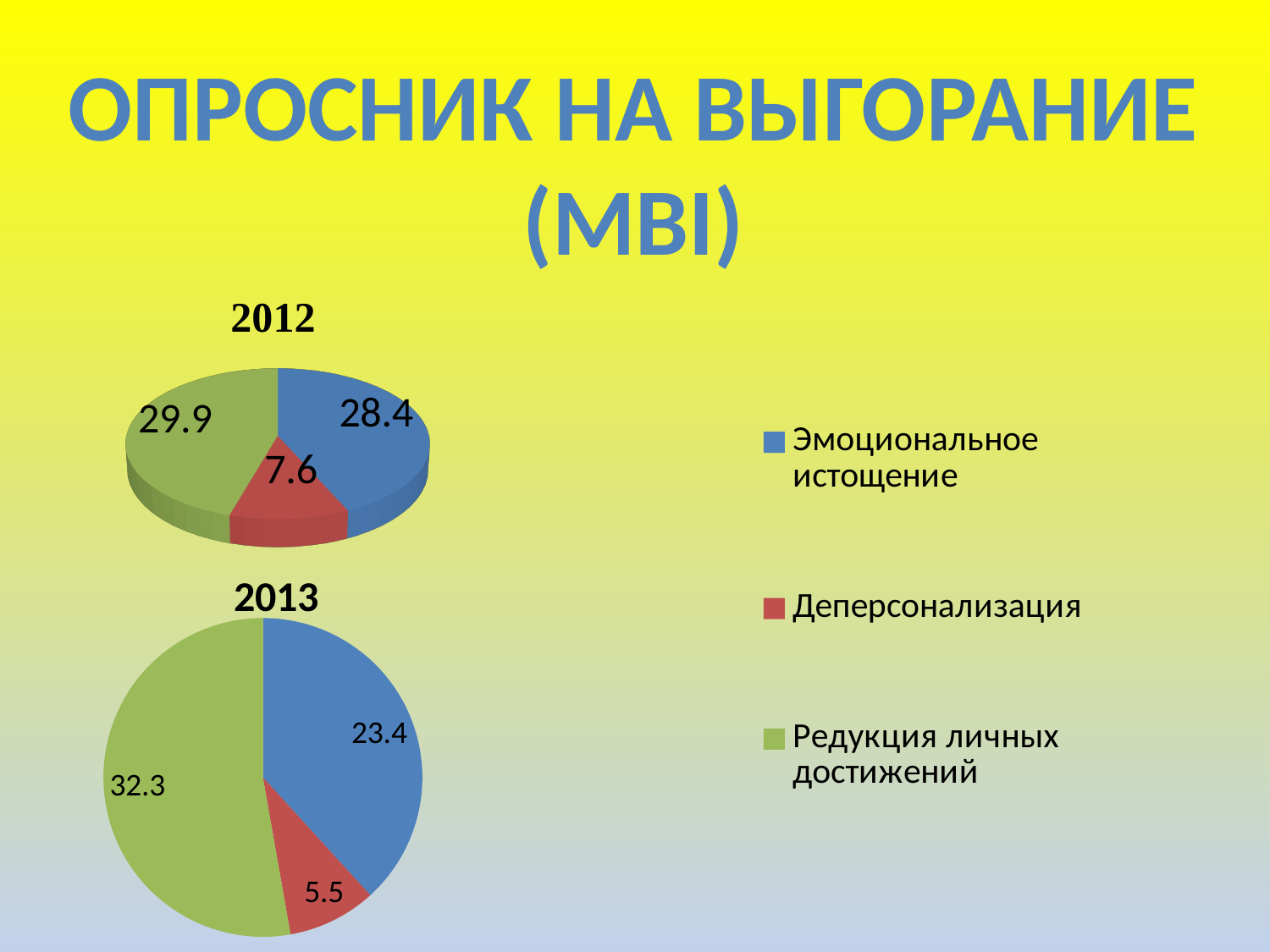
In the 2013 chart, what is the value for Редукция личных достижений? 32.3 How many slices does the 2013 chart have? 3 In the 2013 chart, which category has the largest value? Редукция личных достижений In the 2013 chart, what is the difference between Редукция личных достижений and Эмоциональное истощение? 8.9 In the 2012 chart, what is the difference between Эмоциональное истощение and Деперсонализация? 20.8 In the 2012 chart, what is the value for Эмоциональное истощение? 28.4 Which is larger: Эмоциональное истощение in the 2012 chart or in the 2013 chart? 2012 In the 2012 chart, what is the value for Деперсонализация? 7.6 What type of chart is the 2012 chart? Pie chart In the 2013 chart, what is the value for Деперсонализация? 5.5 Which colour represents Редукция личных достижений in the legend? Green In the 2012 chart, which category has the smallest value? Деперсонализация